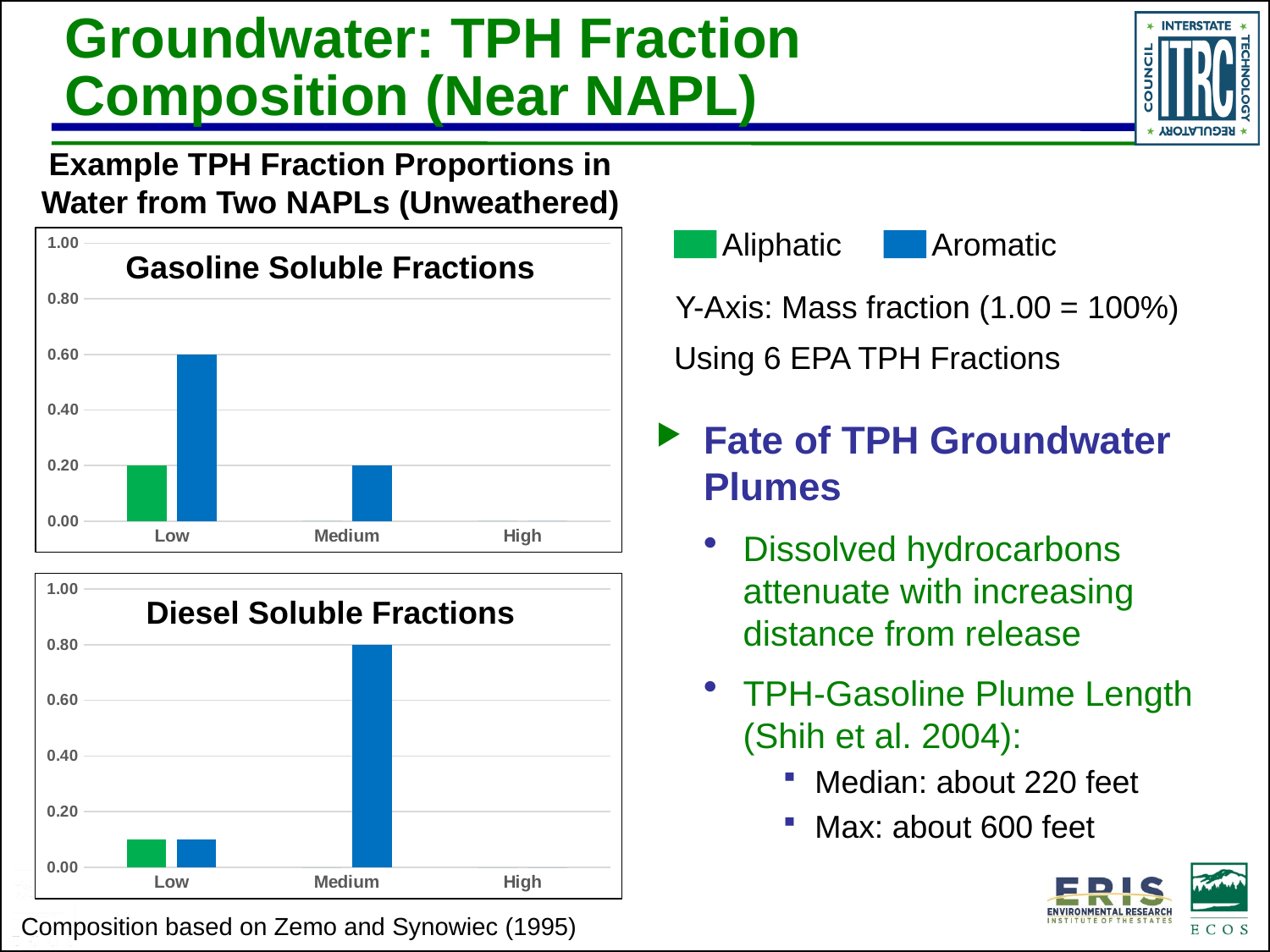
In the Diesel Soluble Fractions chart, what is the Aromatic value for the Medium fraction? 0.80 In the Diesel Soluble Fractions chart, which fraction category has the highest Aromatic value? Medium In the Diesel Soluble Fractions chart, is the Aliphatic value for the Low fraction greater or less than 0.20? less In the Gasoline Soluble Fractions chart, what is the Aromatic value for the Low fraction? 0.60 In the Gasoline Soluble Fractions chart, which fraction category has the highest Aromatic value? Low Which is larger: the Aromatic Low value in the Gasoline Soluble Fractions chart or the Aromatic Medium value in the Diesel Soluble Fractions chart? Aromatic Medium in the Diesel chart How many fraction categories are shown on the x axis of the Gasoline Soluble Fractions chart? 3 In the Gasoline Soluble Fractions chart, what is the Aliphatic value for the Low fraction? 0.20 What kind of chart is the Diesel Soluble Fractions chart? bar chart In the Gasoline Soluble Fractions chart, what is the difference between the Aromatic and Aliphatic values for the Low fraction? 0.40 How many series does the shared legend list for the two charts? 2 In the Gasoline Soluble Fractions chart, what is the Aromatic value for the Medium fraction? 0.20